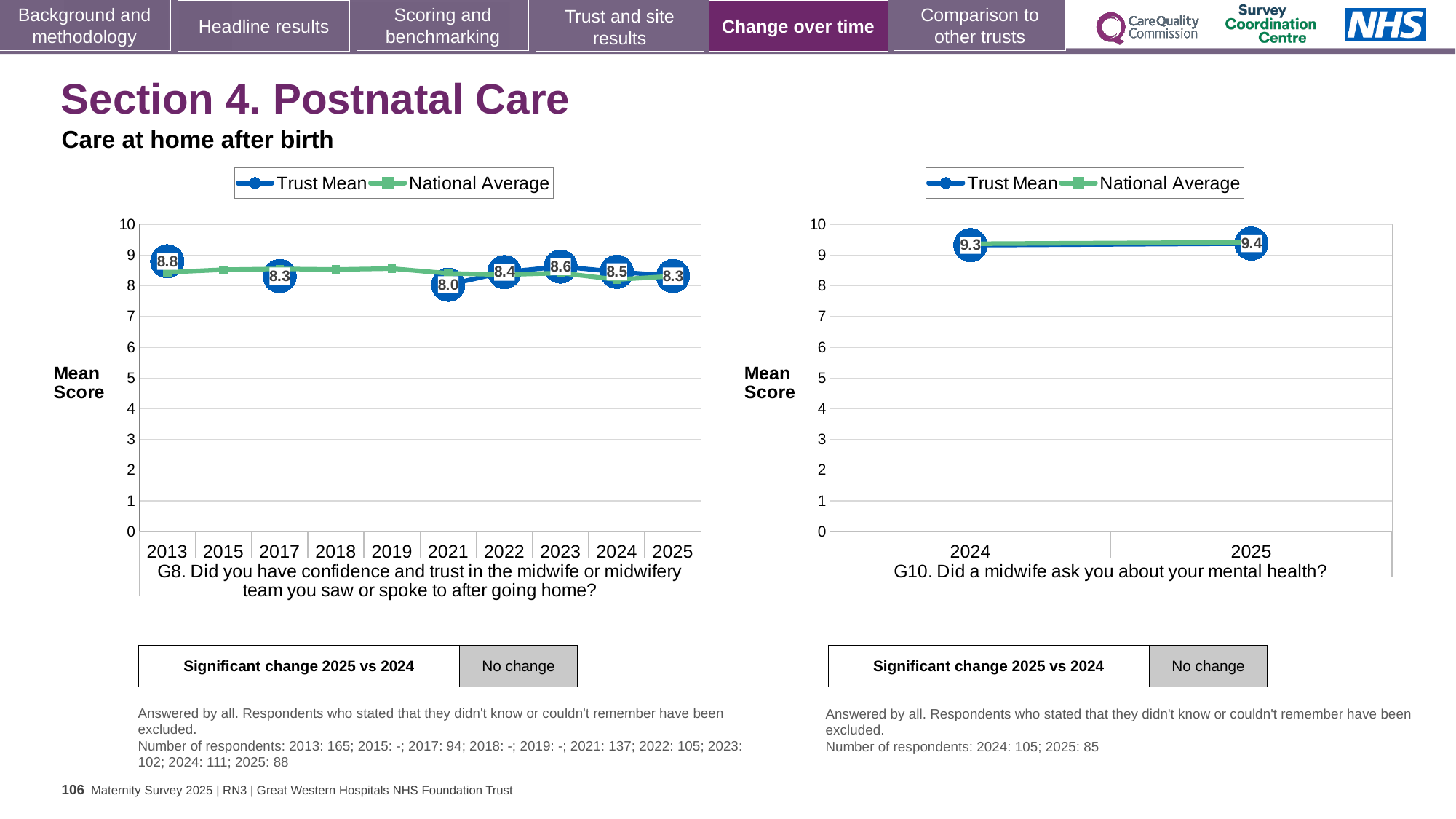
In the G8 chart on the left, what is the Trust Mean score for 2021? 8.0 In the G8 chart on the left, which year has the highest Trust Mean score? 2013 In the G8 chart on the left, is the National Average value for 2013 greater or less than 8? greater In the G10 chart on the right, what is the Trust Mean score for 2025? 9.4 What kind of chart is the G10 chart on the right? Line chart How many series does the legend of the G10 chart on the right list? 2 In the G8 chart on the left, how many years are shown on the x axis? 10 In the G10 chart on the right, does the Trust Mean score rise or fall from 2024 to 2025? Rise In the G8 chart on the left, what is the Trust Mean score for 2013? 8.8 In the G8 chart on the left, which year has the lowest Trust Mean score? 2021 In the G8 chart on the left, is the Trust Mean score higher in 2023 or 2024? 2023 In the G8 chart on the left, what is the difference between the Trust Mean scores for 2013 and 2021? 0.8